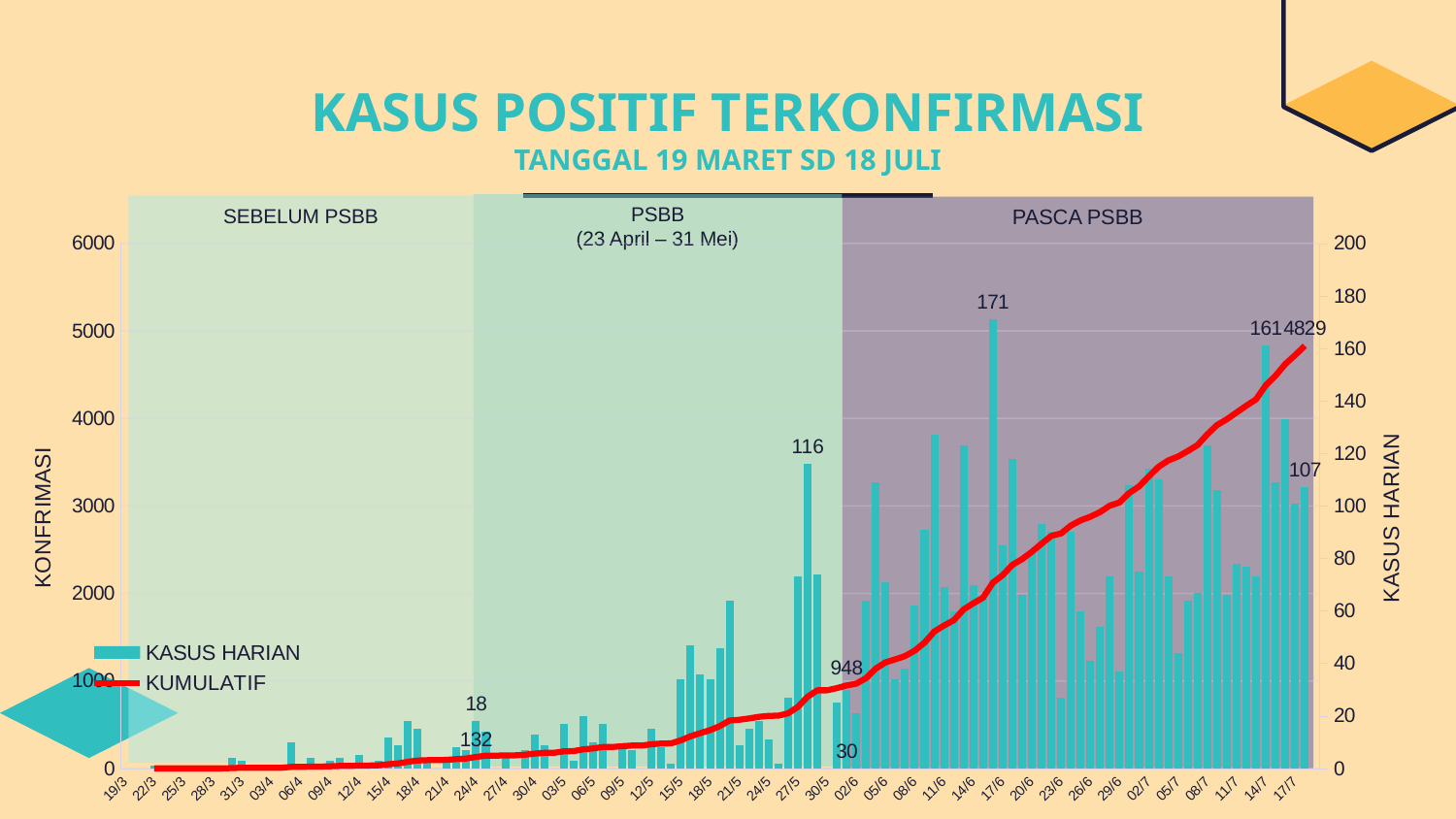
What are the three period labels shown across the top of the chart? SEBELUM PSBB, PSBB, PASCA PSBB What is the highest daily case (KASUS HARIAN) value labeled on the chart? 171 What is the difference between the labeled cumulative values 4829 and 948? 3881 What are the two series named in the legend? KASUS HARIAN and KUMULATIF What is the difference between the labeled daily case values 171 and 116? 55 Does the cumulative (KUMULATIF) line rise or fall from left to right? Rises What is the final cumulative (KUMULATIF) value labeled at the right end of the red line? 4829 How many series does the legend list? 2 What is the smallest daily case value labeled on a bar in the chart? 18 Which labeled daily case value is larger, 161 or 107? 161 What cumulative value is labeled on the red line near the end of the PSBB period? 948 What kind of chart is shown on the slide? A combined bar and line chart